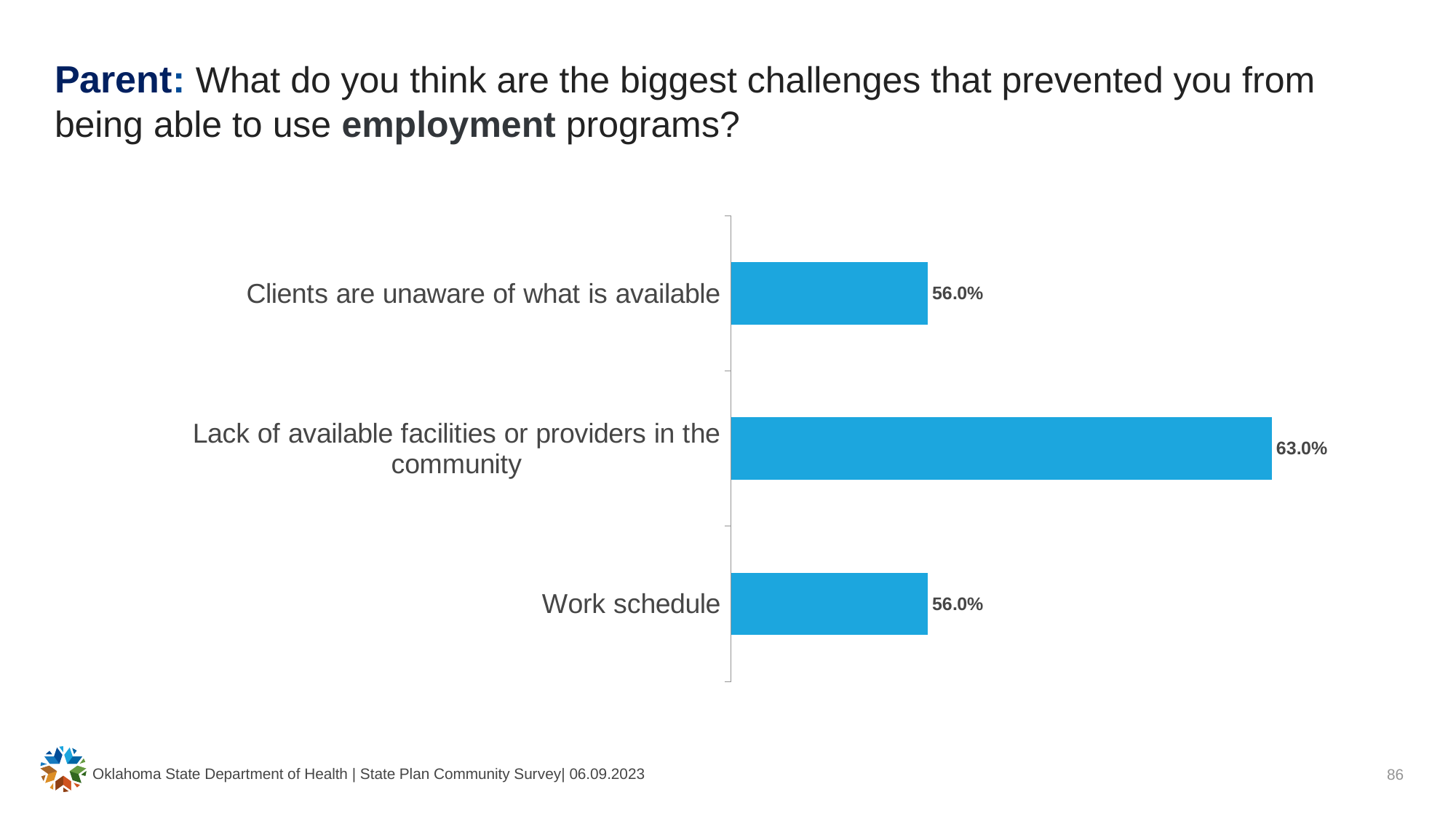
What is the value for "Lack of available facilities or providers in the community"? 63.0% Are the bars in the chart horizontal or vertical? Horizontal Which category has the highest value? Lack of available facilities or providers in the community What is the value for "Clients are unaware of what is available"? 56.0% How many categories are shown in the chart? 3 What is the difference between the values for "Lack of available facilities or providers in the community" and "Work schedule"? 7.0% What colour are the bars in the chart? Blue What kind of chart is shown on the slide? Bar chart Which is larger: the value for "Lack of available facilities or providers in the community" or the value for "Clients are unaware of what is available"? Lack of available facilities or providers in the community What is the value for "Work schedule"? 56.0% Do "Clients are unaware of what is available" and "Work schedule" have the same value? Yes